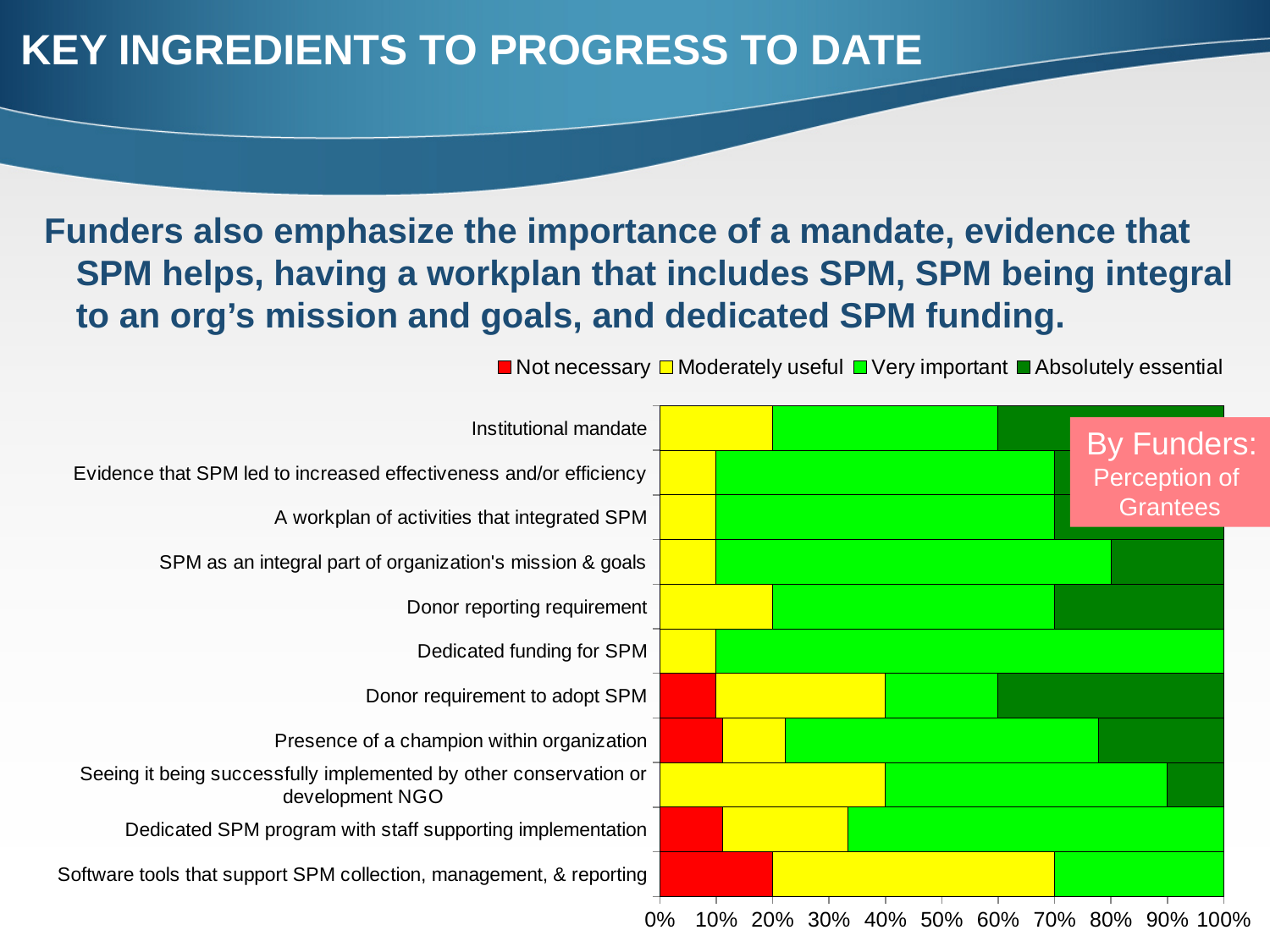
How many categories (ingredients) are plotted on the chart? 11 What is the 'Moderately useful' share for 'Seeing it being successfully implemented by other conservation or development NGO'? 40% What are the four legend entries of the chart? Not necessary, Moderately useful, Very important, Absolutely essential Which category has the largest 'Moderately useful' segment? Software tools that support SPM collection, management, & reporting What kind of chart is shown on the slide? Stacked bar chart How many series does the legend list? 4 Which category has the largest 'Not necessary' segment? Software tools that support SPM collection, management, & reporting What colour represents the 'Not necessary' series? Red What is the 'Not necessary' share for 'Software tools that support SPM collection, management, & reporting'? 20% Is the 'Very important' share for 'Dedicated funding for SPM' greater or less than 80%? greater How many categories have a 'Not necessary' (red) segment? 4 Which has a larger 'Not necessary' share: 'Software tools that support SPM collection, management, & reporting' or 'Donor requirement to adopt SPM'? Software tools that support SPM collection, management, & reporting